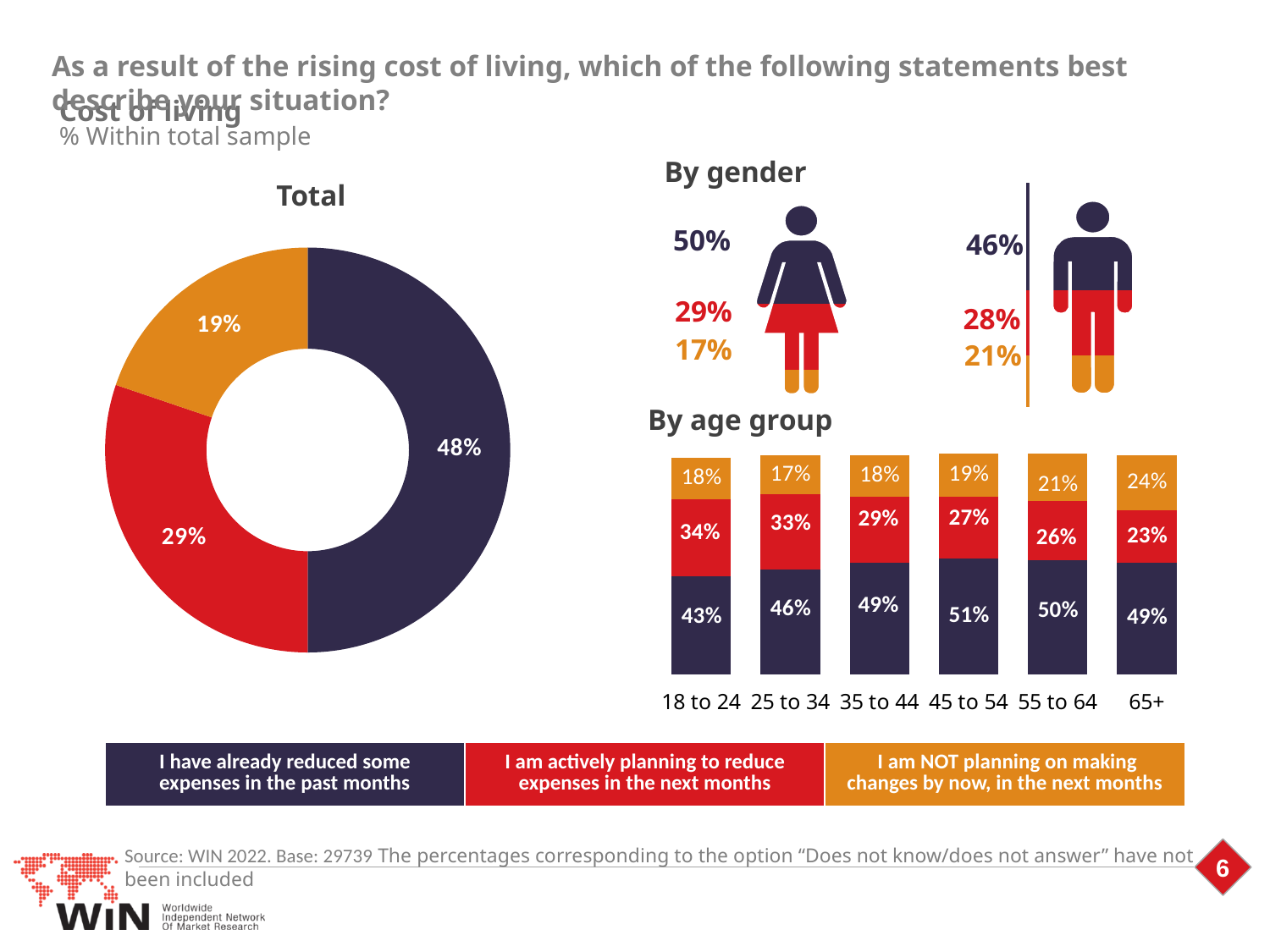
What kind of chart is the 'Total' chart? Donut (pie) chart In the 'Total' chart, what share of respondents say they are NOT planning on making changes by now? 19% How many series does the legend at the bottom of the slide list? 3 In the 'By age group' chart, which age group has the highest value for 'I am NOT planning on making changes by now, in the next months'? 65+ In the 'Total' chart, what share of respondents say they have already reduced some expenses in the past months? 48% In the 'By age group' chart, which age group has the lowest value for 'I have already reduced some expenses in the past months'? 18 to 24 In the 'By age group' chart, what is the value for 'I am actively planning to reduce expenses in the next months' for the 18 to 24 age group? 34% In the 'By age group' chart, does the value for 'I am actively planning to reduce expenses in the next months' generally rise or fall from 18 to 24 to 65+? Fall In the 'By age group' chart, what is the difference between the 'I am actively planning to reduce expenses in the next months' values for 18 to 24 and 65+? 11 percentage points In the 'By gender' section, which is larger: the share of women or the share of men who have already reduced some expenses in the past months? Women (50%) In the 'By age group' chart, what is the value for 'I have already reduced some expenses in the past months' for the 45 to 54 age group? 51% In the 'By age group' chart, how many age groups are shown? 6